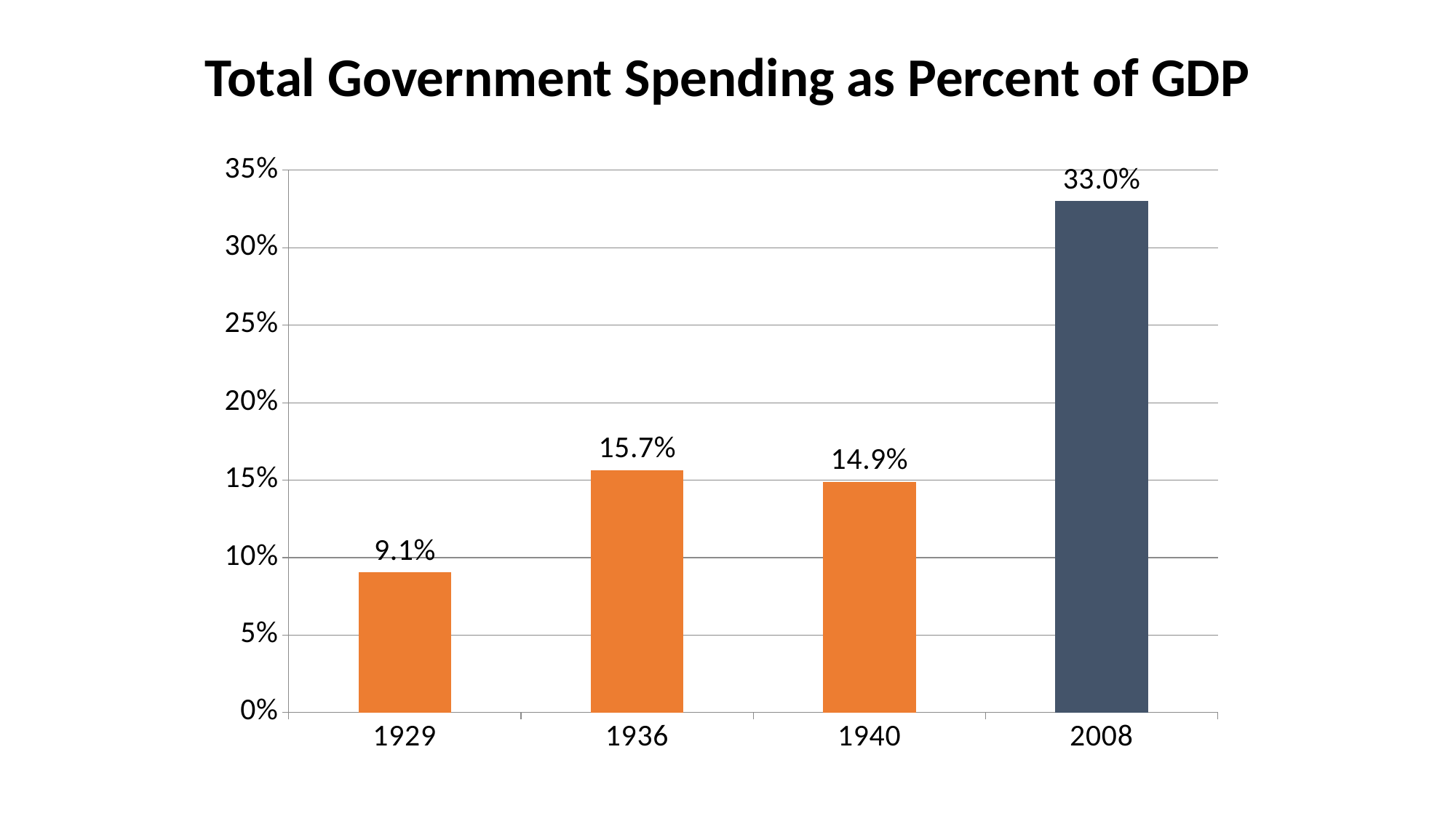
How many years are shown on the chart? 4 What is the value for 1936? 15.7% What is the value for 2008? 33.0% What is the difference between the values for 1936 and 1940? 0.8% Which is larger, the value for 1936 or the value for 1940? 1936 What kind of chart is this? bar chart What is the value for 1940? 14.9% What is the value for 1929? 9.1% What is the title of the chart? Total Government Spending as Percent of GDP Which year has the lowest value? 1929 What is the difference between the values for 2008 and 1929? 23.9% Which year has the highest value? 2008